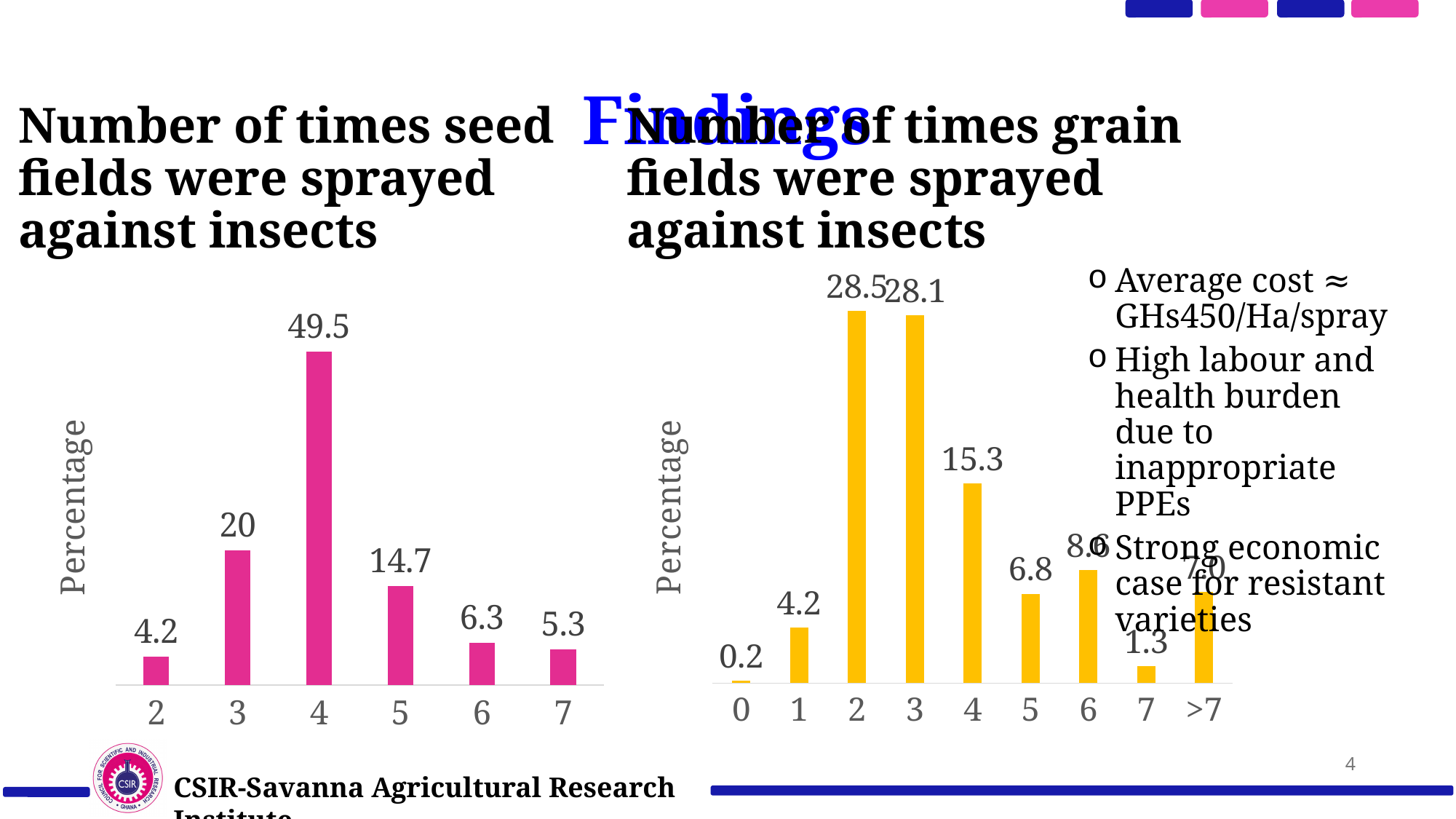
What type of chart is 'Number of times seed fields were sprayed against insects'? Bar chart In the chart 'Number of times seed fields were sprayed against insects', how many categories are shown on the x axis? 6 In the chart 'Number of times seed fields were sprayed against insects', what is the difference between the percentages for 3 sprays and 5 sprays? 5.3 In the chart 'Number of times grain fields were sprayed against insects', what is the difference between the percentages for 2 sprays and 3 sprays? 0.4 In the chart 'Number of times seed fields were sprayed against insects', which number of sprays has the lowest percentage? 2 In the chart 'Number of times grain fields were sprayed against insects', which number of sprays has the highest percentage? 2 In the chart 'Number of times grain fields were sprayed against insects', what is the percentage for 0 sprays? 0.2 In the chart 'Number of times seed fields were sprayed against insects', which number of sprays has the highest percentage? 4 What is the y-axis label of the chart 'Number of times grain fields were sprayed against insects'? Percentage In the chart 'Number of times seed fields were sprayed against insects', what is the percentage for 4 sprays? 49.5 In the chart 'Number of times grain fields were sprayed against insects', what is the percentage for 4 sprays? 15.3 In the chart 'Number of times grain fields were sprayed against insects', which is larger, the percentage for 5 sprays or for 6 sprays? 6 sprays